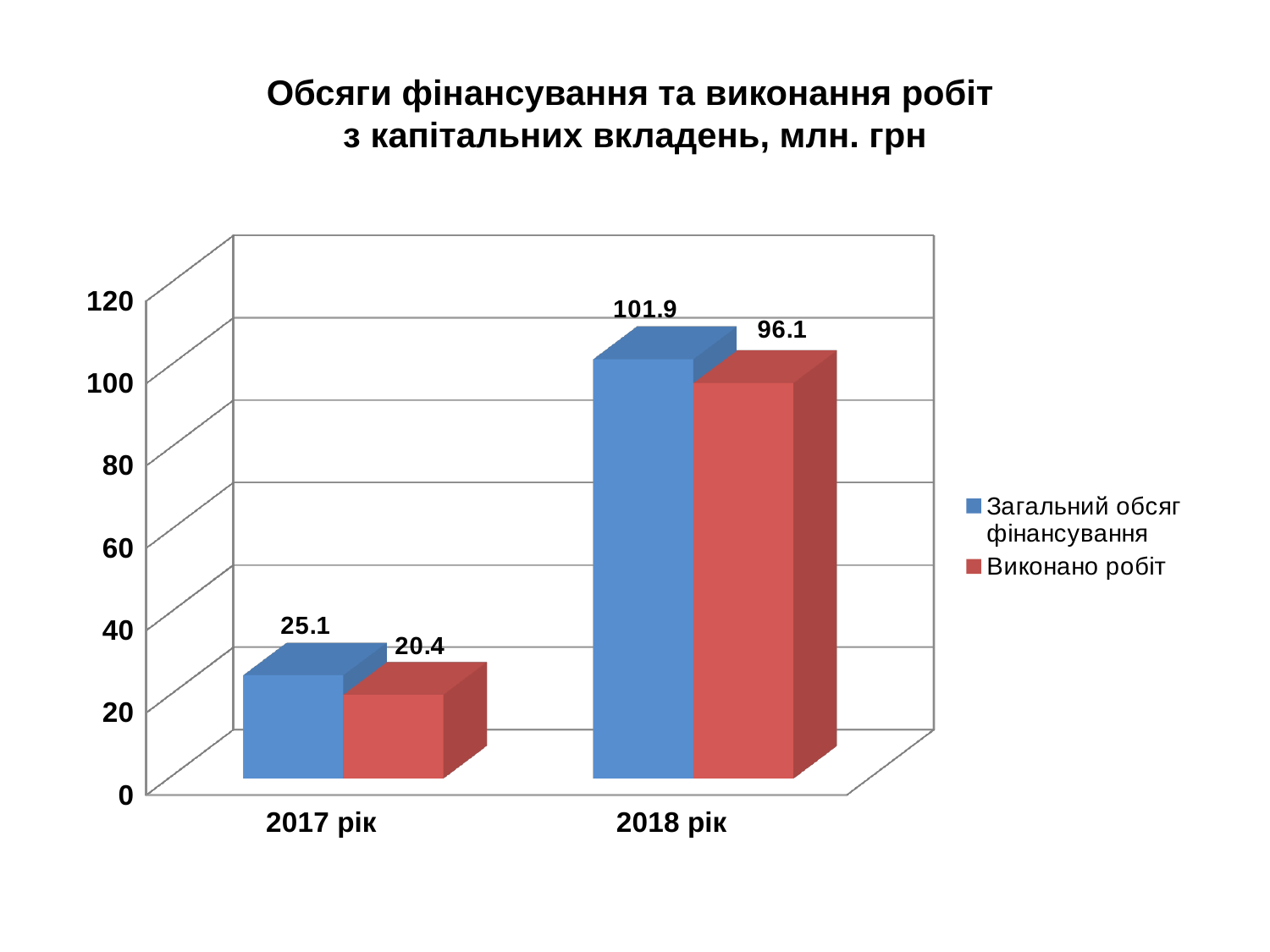
Which year has the lowest value for "Виконано робіт"? 2017 рік Which is larger in 2017 рік: "Загальний обсяг фінансування" or "Виконано робіт"? Загальний обсяг фінансування How many years (categories) are shown on the x axis? 2 What is the value of "Виконано робіт" for 2018 рік? 96.1 What is the value of "Загальний обсяг фінансування" for 2018 рік? 101.9 What kind of chart is shown on the slide? Bar chart What is the value of "Виконано робіт" for 2017 рік? 20.4 Do the values for "Виконано робіт" rise or fall from 2017 рік to 2018 рік? Rise What is the difference between "Загальний обсяг фінансування" and "Виконано робіт" in 2018 рік? 5.8 Which year has the highest value for "Загальний обсяг фінансування"? 2018 рік What is the value of "Загальний обсяг фінансування" for 2017 рік? 25.1 How many series does the legend list? 2